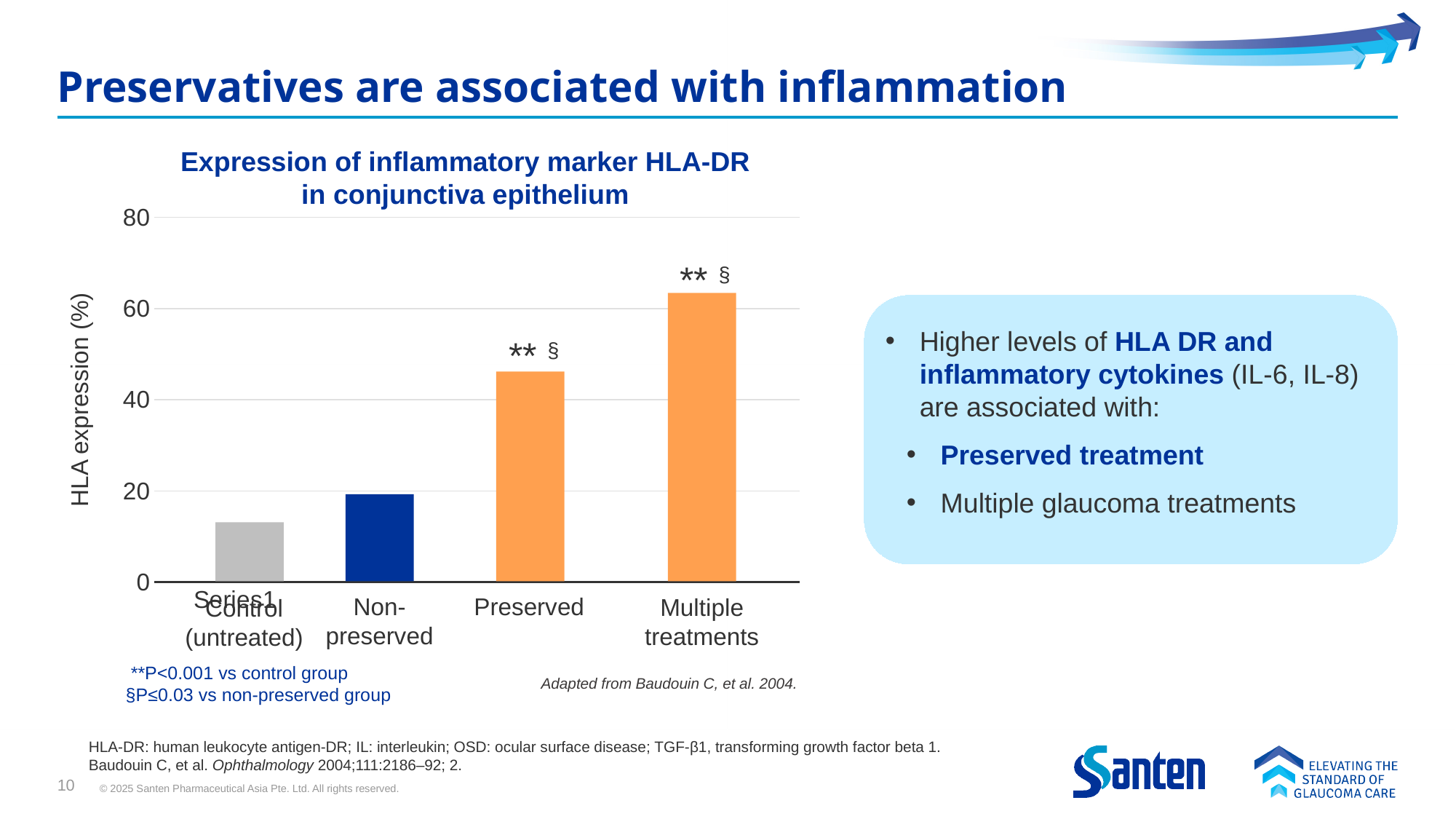
Do the bar values rise or fall from left to right across the categories? rise What is the label of the y axis? HLA expression (%) Which category has the highest HLA expression? Multiple treatments Is the HLA expression for Multiple treatments greater or less than 60? greater What kind of chart is shown on the slide? bar chart Is the HLA expression for Control (untreated) greater or less than 20? less What is the title of the chart? Expression of inflammatory marker HLA-DR in conjunctiva epithelium Is the HLA expression for Preserved greater or less than 60? less How many categories (bars) are plotted in the chart? 4 Which category has the lowest HLA expression? Control (untreated) Which has a higher HLA expression, Preserved or Non-preserved? Preserved